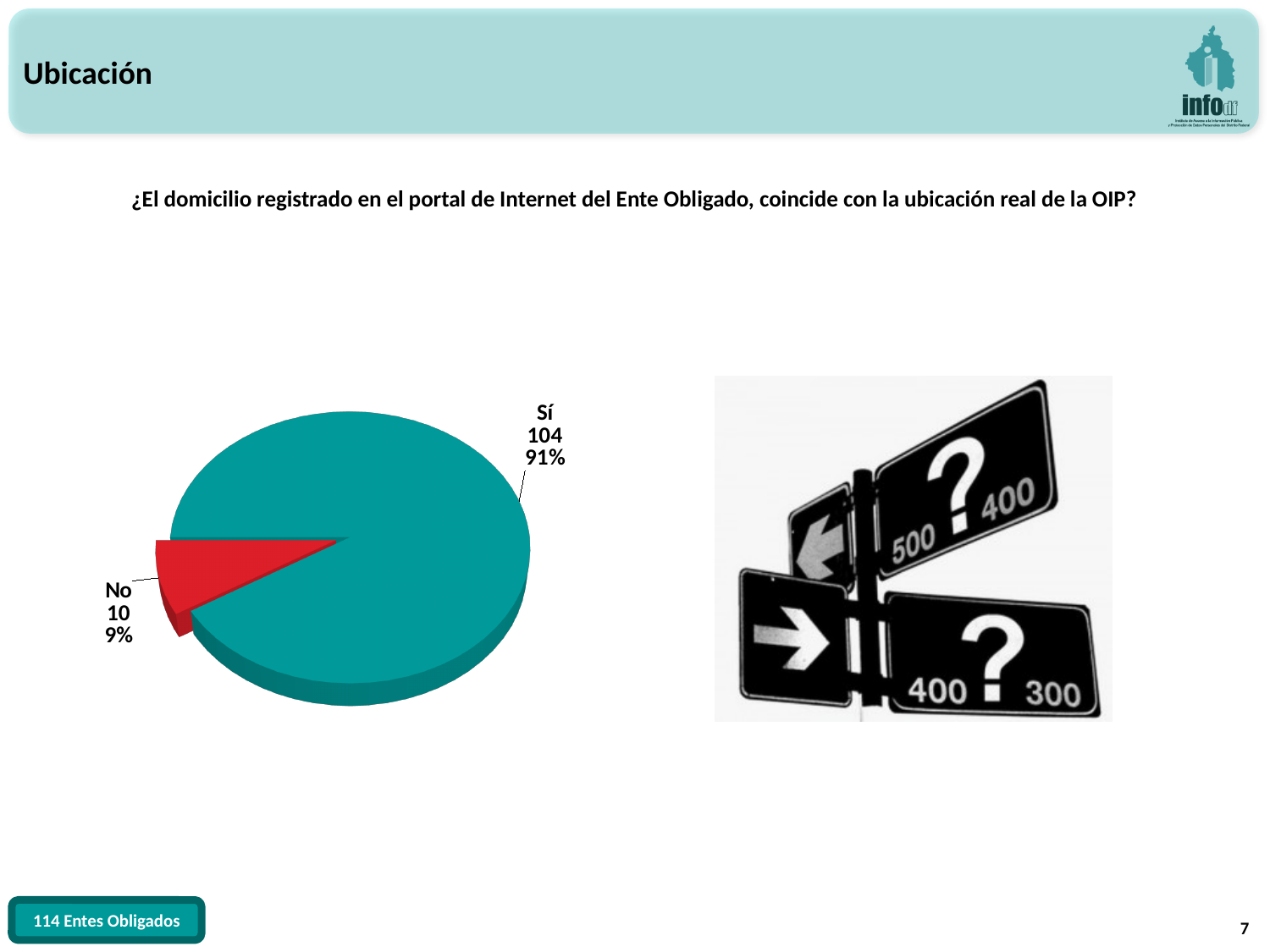
Which has a larger count, "Sí" or "No"? Sí What colour is the "No" slice of the pie chart? red Which slice is the smallest in the pie chart? No Which slice is the largest in the pie chart? Sí What is the total of the counts shown in the pie chart? 114 What is the count shown for the "Sí" slice? 104 What percentage share does the "Sí" slice represent? 91% What is the count shown for the "No" slice? 10 What is the difference between the counts for "Sí" and "No"? 94 How many slices does the pie chart have? 2 What percentage share does the "No" slice represent? 9% What kind of chart is shown on the slide? pie chart